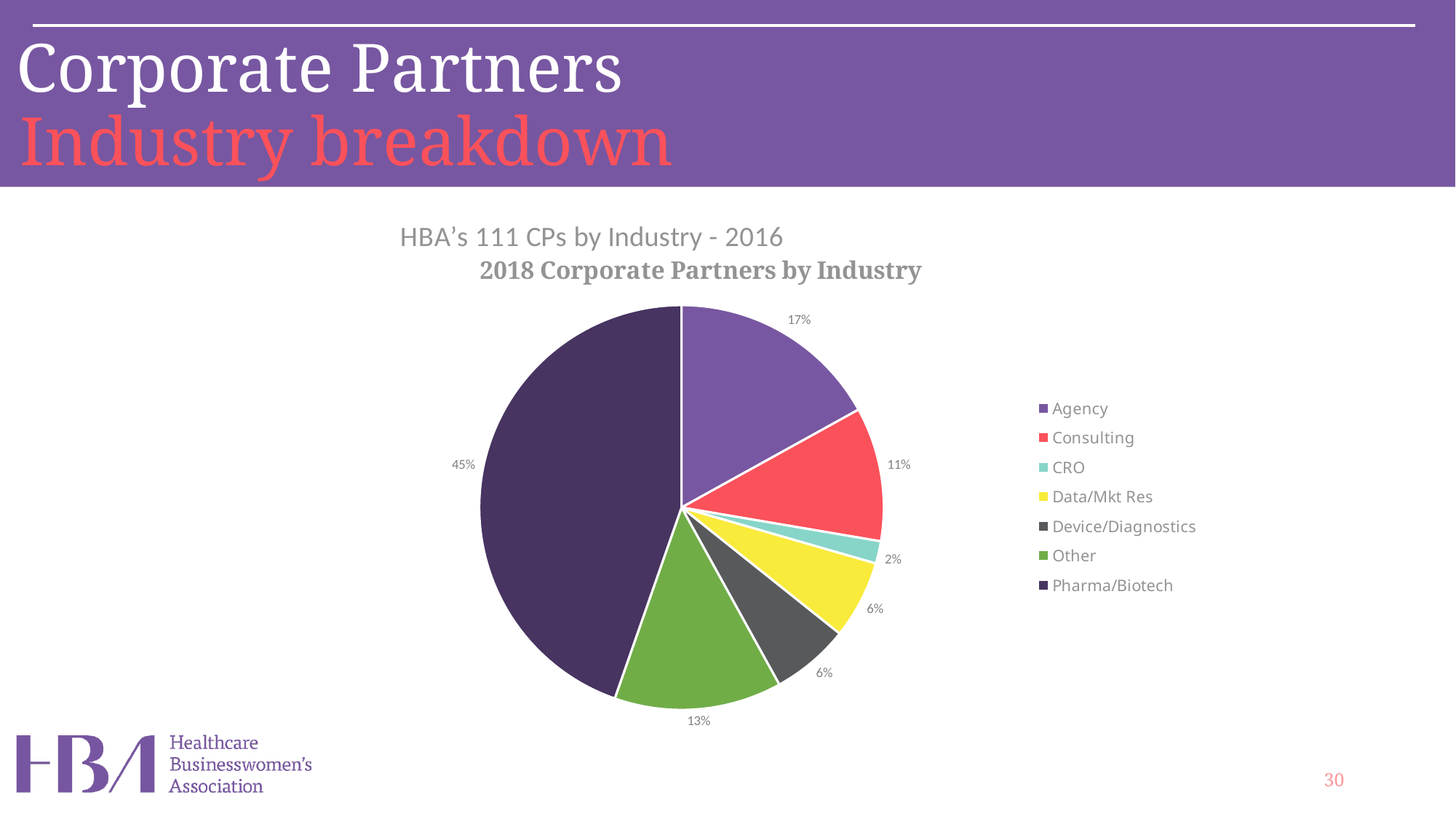
What is the title of the pie chart? 2018 Corporate Partners by Industry What percentage is shown for Other? 13% What percentage is shown for CRO? 2% What percentage of 2018 Corporate Partners are in Pharma/Biotech? 45% What is the difference in percentage points between Pharma/Biotech and Agency? 28 Which has a larger share, Consulting or Other? Other How many industry categories does the legend list? 7 What share of the pie does Agency represent? 17% What percentage is shown for Consulting? 11% Which industry has the largest share of 2018 Corporate Partners? Pharma/Biotech What type of chart is shown on the slide? Pie chart Which industry has the smallest share of 2018 Corporate Partners? CRO